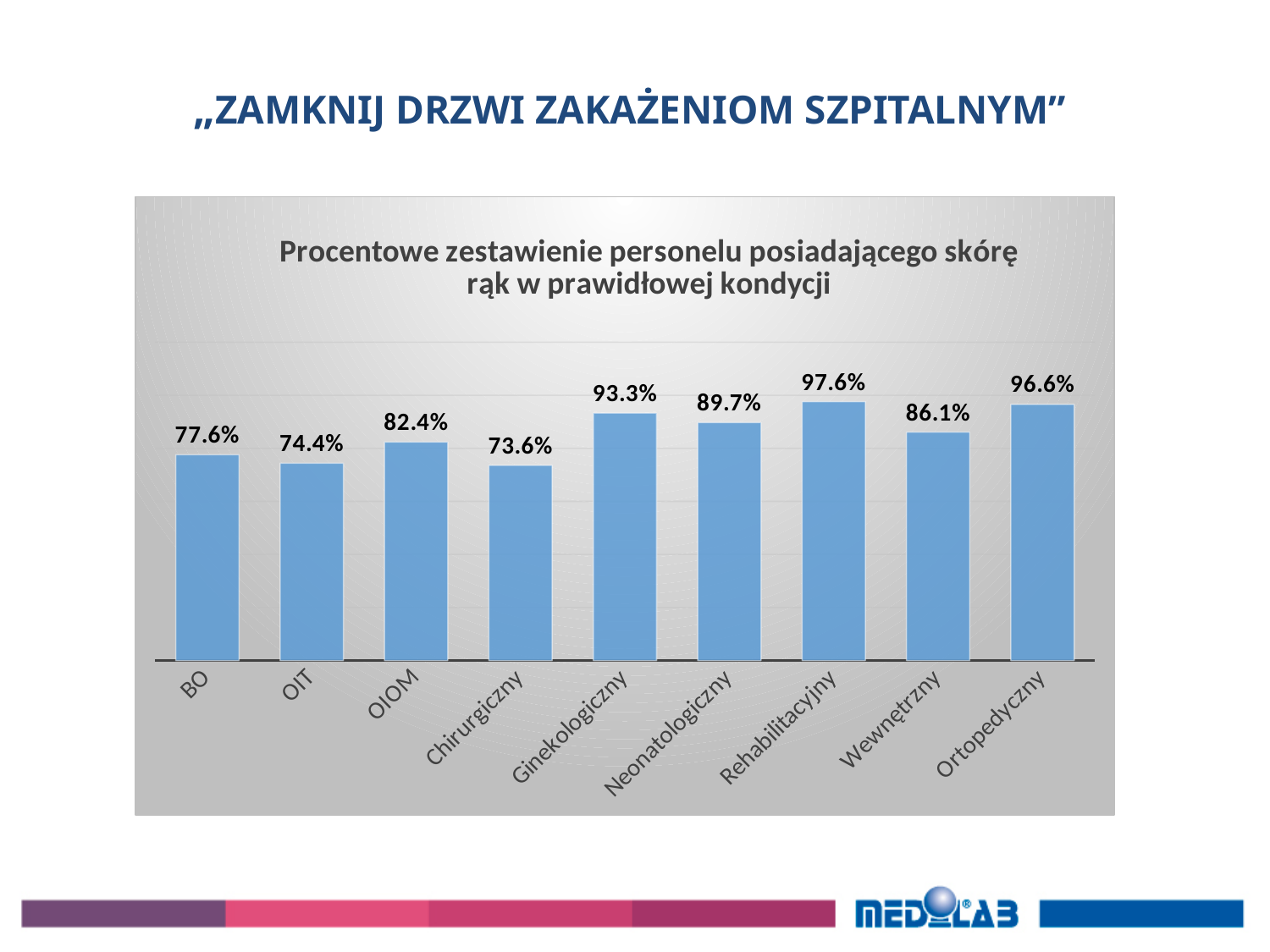
What is the title of the chart? Procentowe zestawienie personelu posiadającego skórę rąk w prawidłowej kondycji Which is larger, the value for Ortopedyczny or the value for Ginekologiczny? Ortopedyczny What kind of chart is shown on the slide? Bar chart What is the difference between the values for Rehabilitacyjny and Chirurgiczny? 24.0% What is the difference between the values for Neonatologiczny and BO? 12.1% Which is larger, the value for OIT or the value for OIOM? OIOM What is the value for OIOM? 82.4% How many categories are shown in the chart? 9 What is the value for Wewnętrzny? 86.1% What is the value for Ginekologiczny? 93.3% Which category has the lowest value? Chirurgiczny Which category has the highest value? Rehabilitacyjny